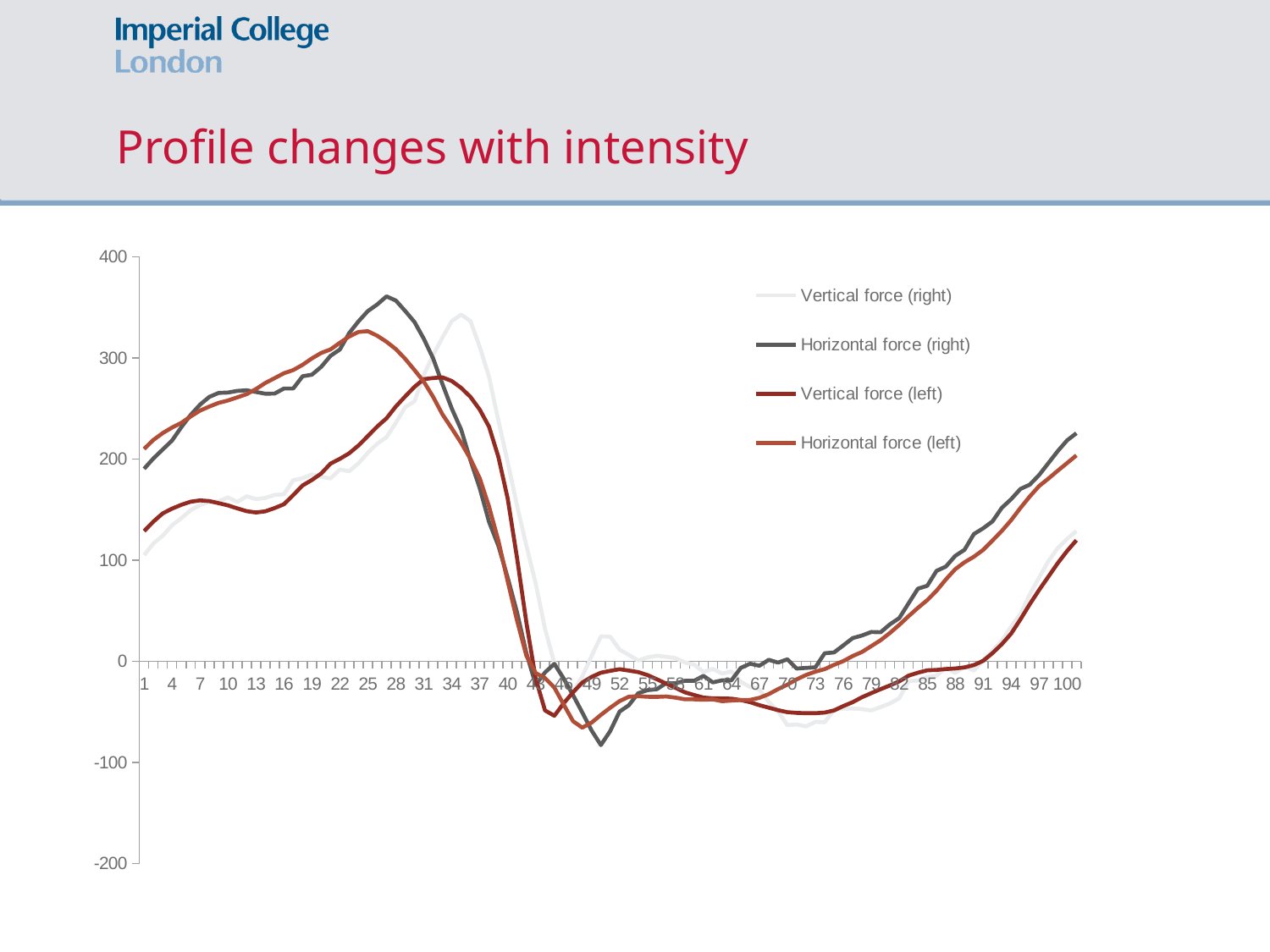
What is the title of the slide containing the chart? Profile changes with intensity Is the value of Horizontal force (left) at x = 100 greater or less than 100? greater Does Vertical force (left) rise or fall between x = 1 and x = 31? rise At x = 1, which is larger: Horizontal force (right) or Vertical force (left)? Horizontal force (right) What kind of chart is shown on the slide? line chart What are the four series named in the legend? Vertical force (right), Horizontal force (right), Vertical force (left), Horizontal force (left) Is the value of Horizontal force (right) at x = 49 greater or less than 0? less Is the value of Vertical force (right) at x = 34 greater or less than 300? greater How many series does the legend list? 4 At x = 100, which is larger: Horizontal force (right) or Vertical force (left)? Horizontal force (right) Does Horizontal force (right) rise or fall between x = 28 and x = 49? fall